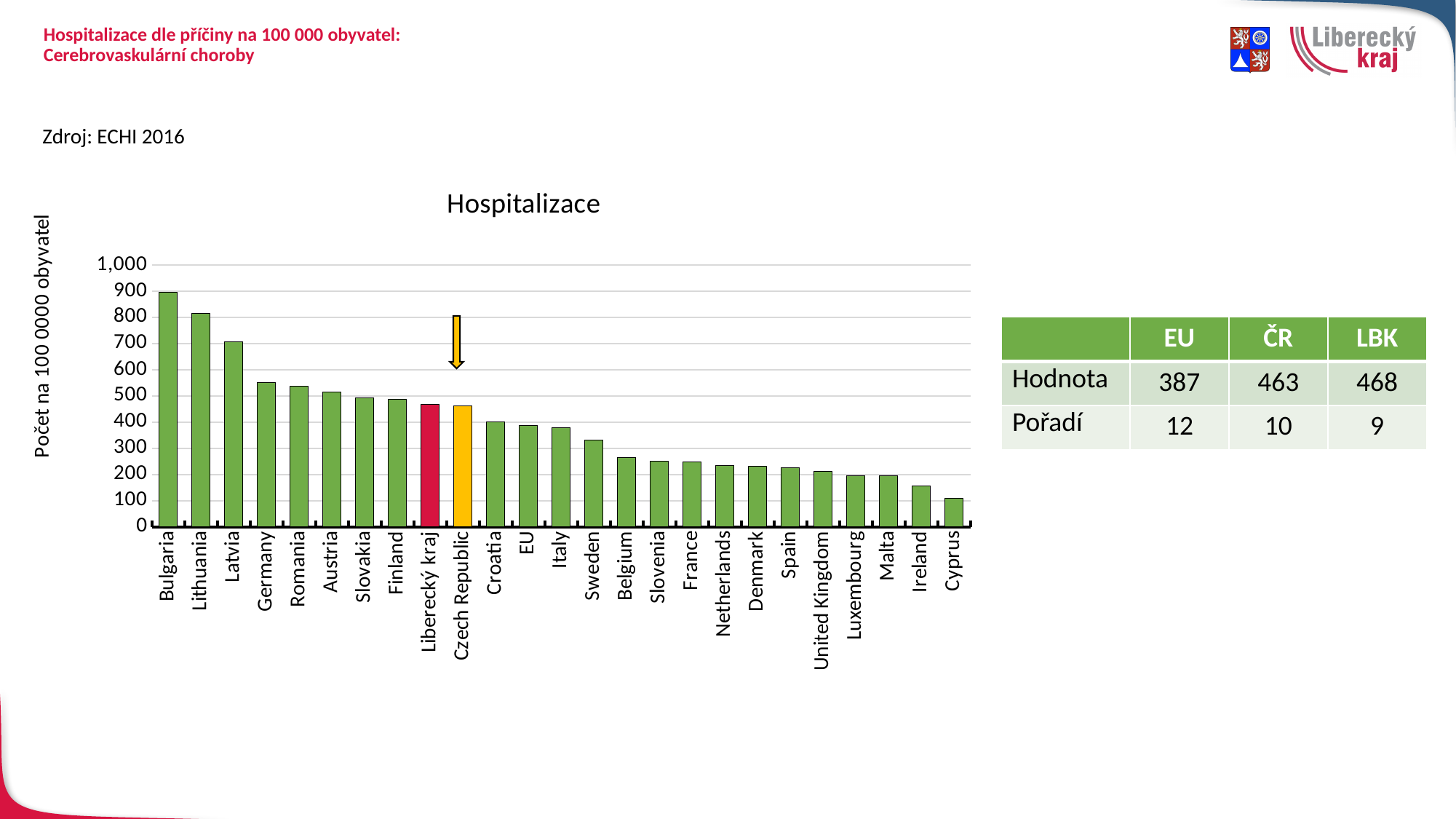
How many categories (bars) are shown in the chart? 25 What is the difference between the values for the Czech Republic (ČR) and the EU? 76 What is the hospitalization value for Liberecký kraj (LBK) according to the slide? 468 Is the value for Cyprus greater or less than 200? less Is the value for Bulgaria greater or less than 800? greater What is the hospitalization value for the EU according to the slide? 387 Which country has the highest hospitalization value in the chart? Bulgaria What is the hospitalization value for the Czech Republic (ČR) according to the slide? 463 Which country has the lowest hospitalization value in the chart? Cyprus What is the difference between the values for Liberecký kraj (LBK) and the Czech Republic (ČR)? 5 What type of chart is shown on the slide? bar chart Do the values rise or fall from left to right along the x axis? fall